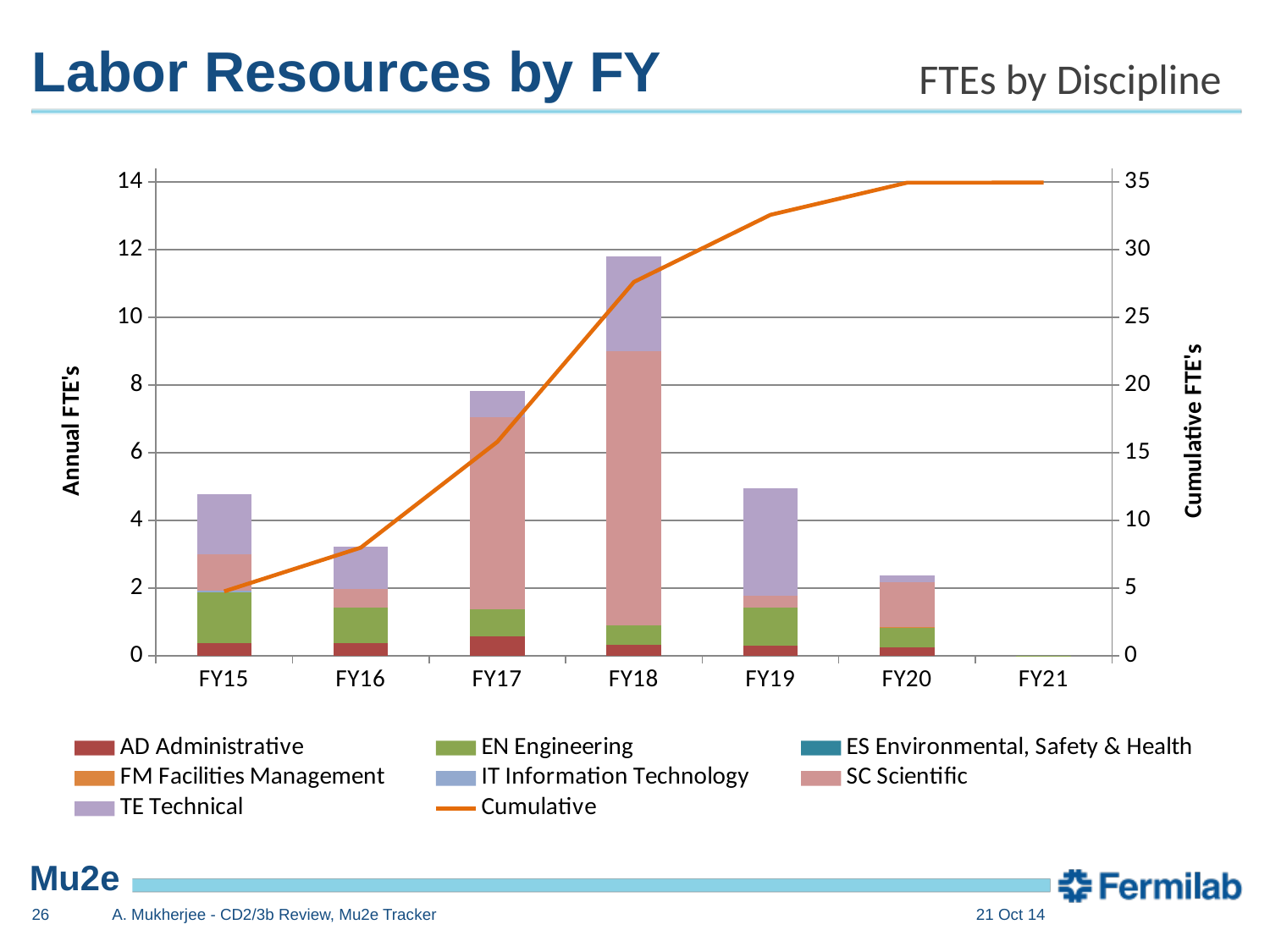
Which fiscal year has the tallest stacked bar? FY18 What is the label of the right-hand vertical axis? Cumulative FTE's What kind of chart is shown on the slide? Stacked bar chart with a line Among the fiscal years that have a bar, which has the shortest stacked bar? FY20 Is the total annual FTE bar for FY16 greater or less than 4? less How many fiscal years are labelled on the x axis? 7 Is the total annual FTE bar for FY17 greater or less than 6? greater How many entries does the legend list? 8 Which has the taller stacked bar, FY17 or FY19? FY17 Is the Cumulative value at FY19 greater or less than 30 on the right axis? greater Does the Cumulative line rise or fall from FY15 to FY19? rises